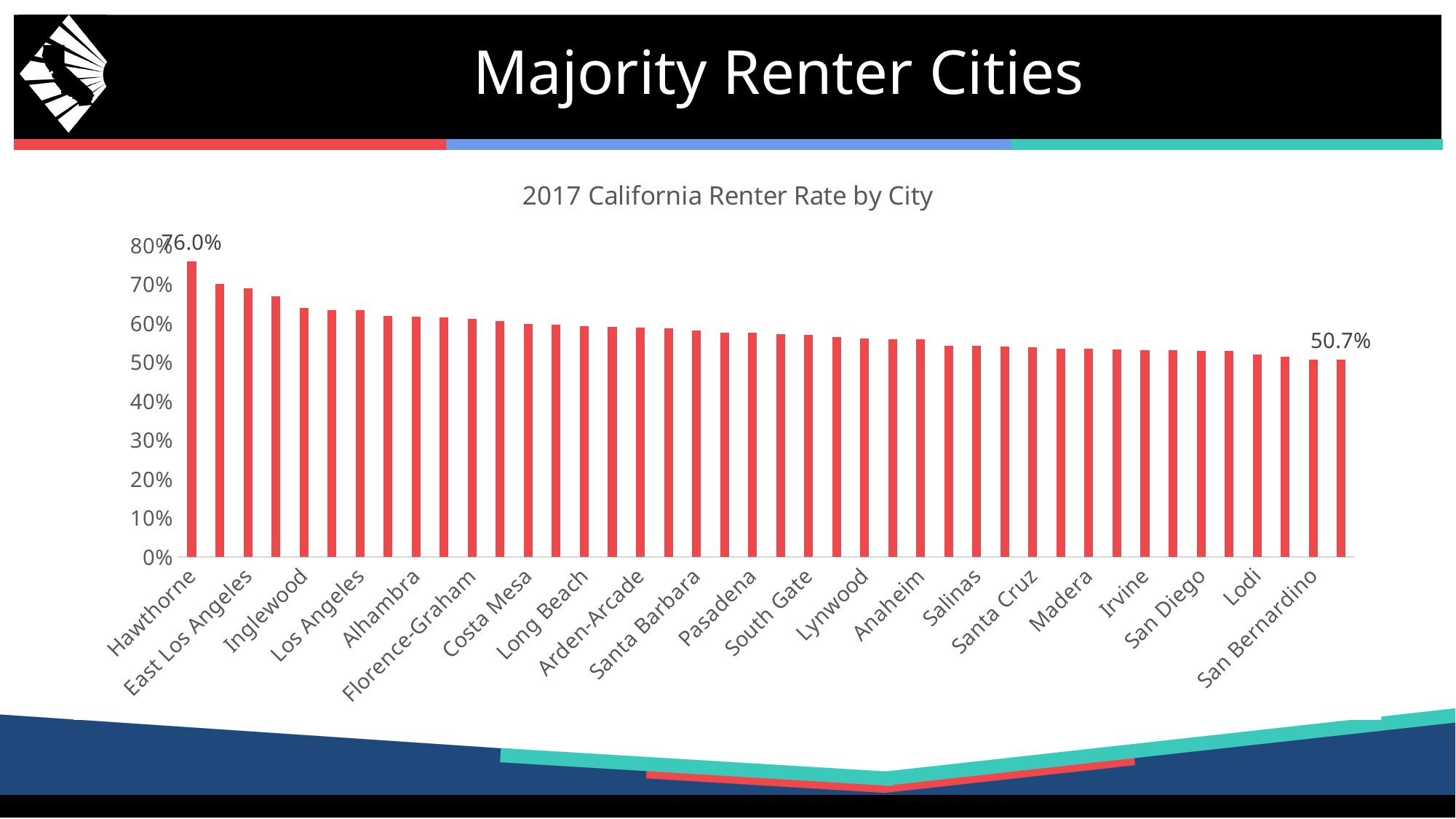
Which city has a higher renter rate, Hawthorne or San Bernardino? Hawthorne Is the value for Anaheim greater or less than 50%? greater Which city has the highest renter rate? Hawthorne What is the title of the chart? 2017 California Renter Rate by City Do the renter rates rise or fall from left to right along the x axis? Fall What kind of chart is shown on the slide? Bar chart Is the value for Inglewood greater or less than 60%? greater Is the value for Irvine greater or less than 60%? less What is the renter rate for Hawthorne? 76.0%